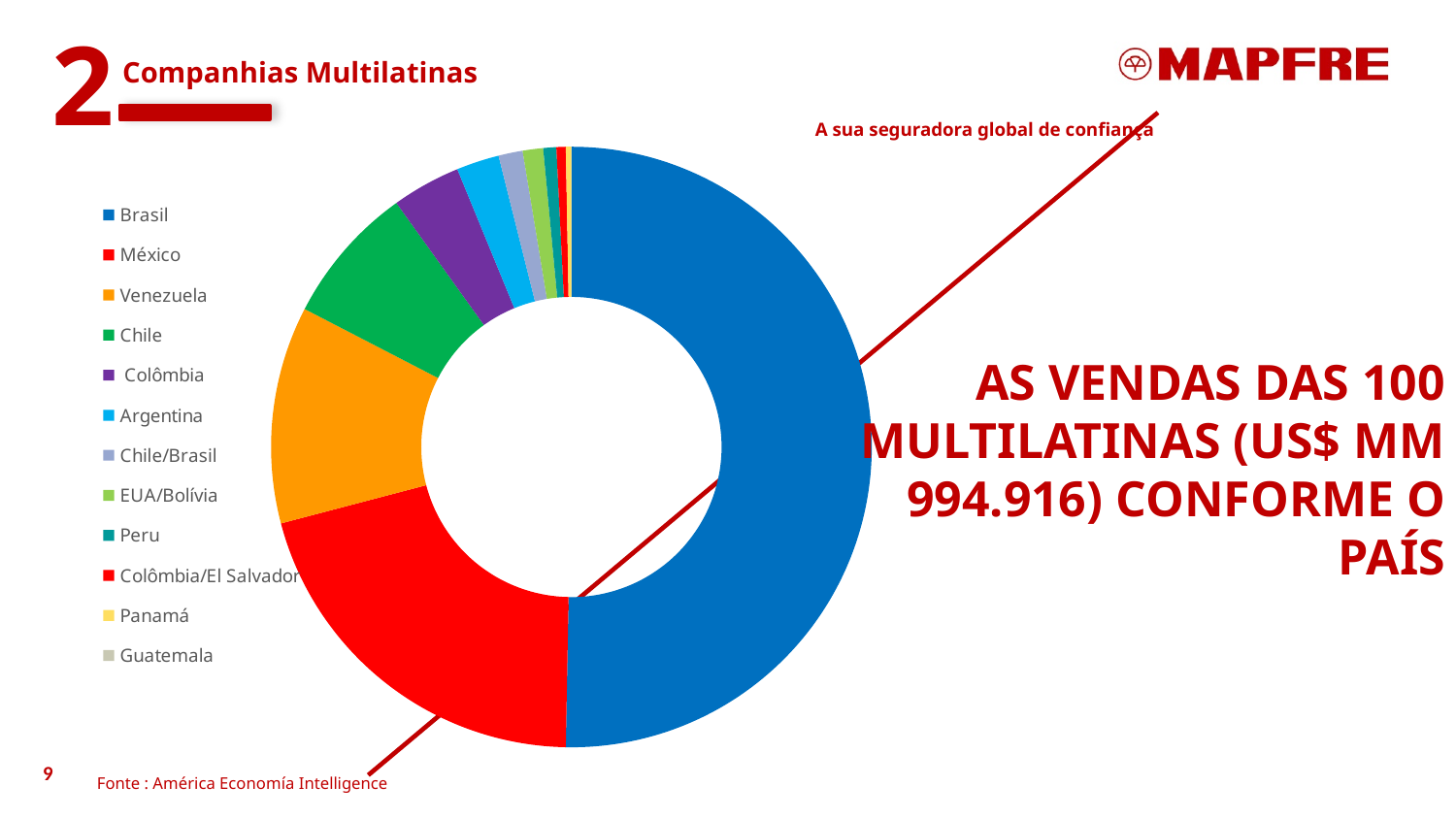
What kind of chart is shown on the slide? Doughnut (pie) chart Which slice is larger, Argentina or Brasil? Brasil What colour is used for Brasil in the chart? Blue Which country has the largest slice of the chart? Brasil Which slice is larger, Chile or Colômbia? Chile Which country has the second-largest slice of the chart? México What is the source cited for the chart? América Economía Intelligence How many countries or country groups does the legend list? 12